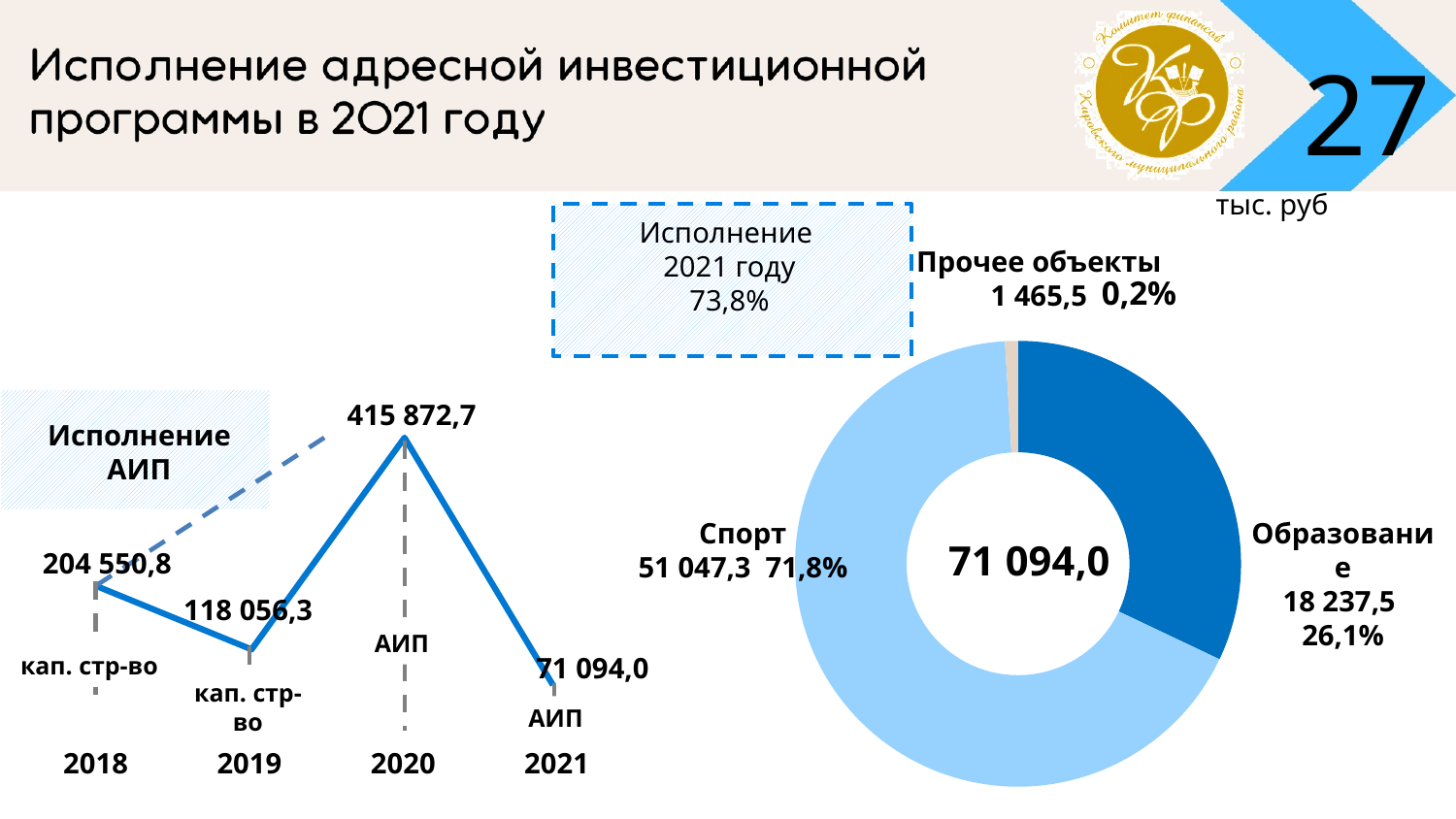
On the line chart on the left, how many years are plotted? 4 On the line chart on the left, what is the difference between the values for 2020 and 2021? 344 778,7 On the line chart on the left, which year has the lowest value? 2021 On the line chart on the left, which year has the highest value? 2020 On the line chart on the left, what is the value for 2018? 204 550,8 On the line chart on the left, what is the value for 2020? 415 872,7 On the doughnut chart on the right, which category has the smallest value? Прочее объекты On the doughnut chart on the right, what share does Образование have? 26,1% What total is shown in the centre of the doughnut chart on the right? 71 094,0 On the line chart on the left, which is larger: the value for 2018 or the value for 2019? 2018 On the doughnut chart on the right, what is the value for Спорт? 51 047,3 What kind of chart is shown on the left of the slide? line chart